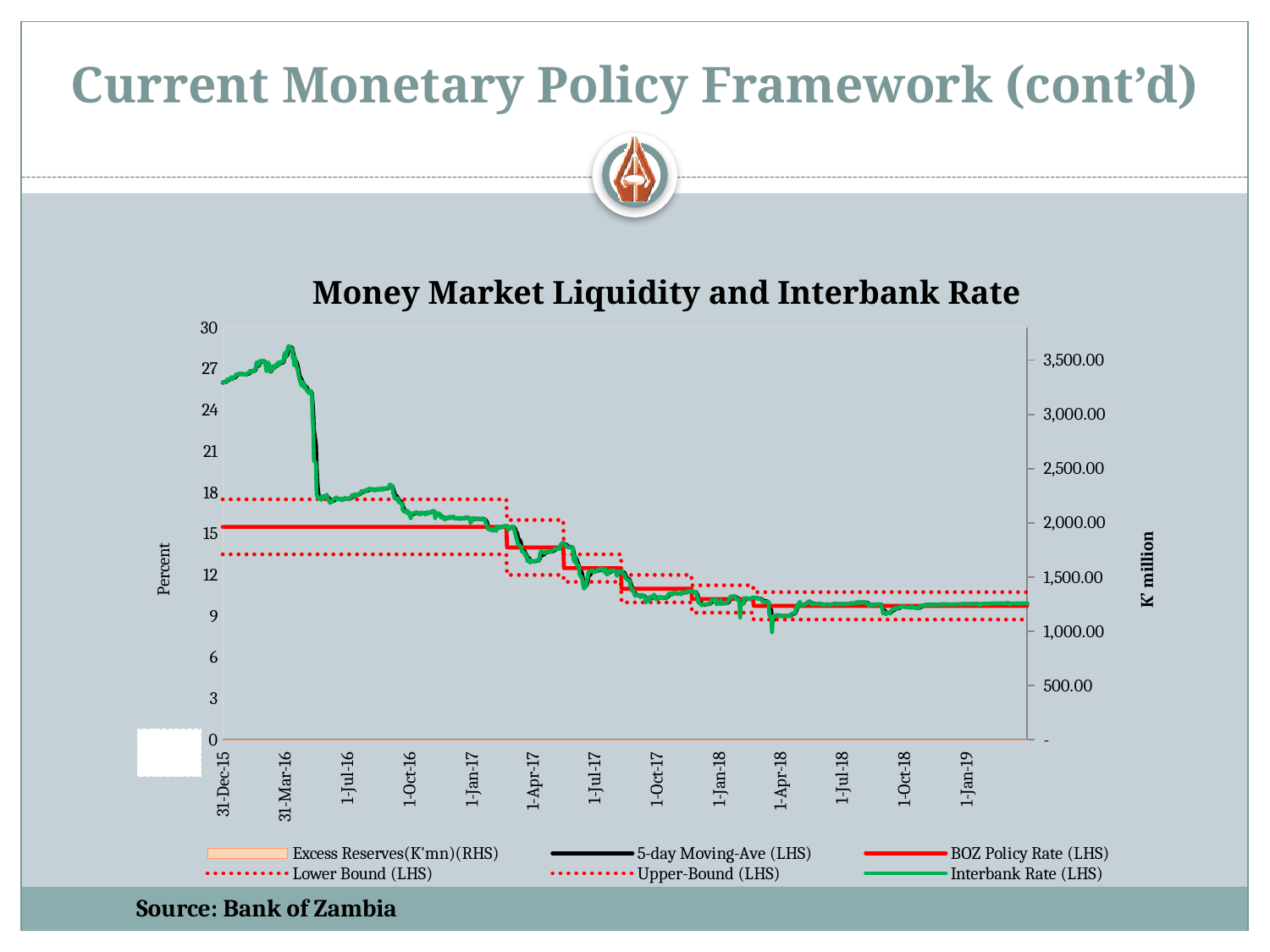
What is the source cited for the chart? Bank of Zambia What type of chart is shown on the slide? line chart Is the Interbank Rate (LHS) at 31-Dec-15 greater or less than 24 percent? greater Is the Interbank Rate (LHS) at 1-Jan-19 greater or less than 12 percent? less Which is higher, the Interbank Rate (LHS) at 31-Dec-15 or at 1-Jan-19? 31-Dec-15 What is the title of the chart? Money Market Liquidity and Interbank Rate Is the Lower Bound (LHS) at 1-Jul-16 greater or less than 15 percent? less How many date labels are shown on the x axis of the chart? 13 Does the Interbank Rate (LHS) generally rise or fall from 31-Mar-16 to 1-Jan-19? fall How many series does the chart legend list? 6